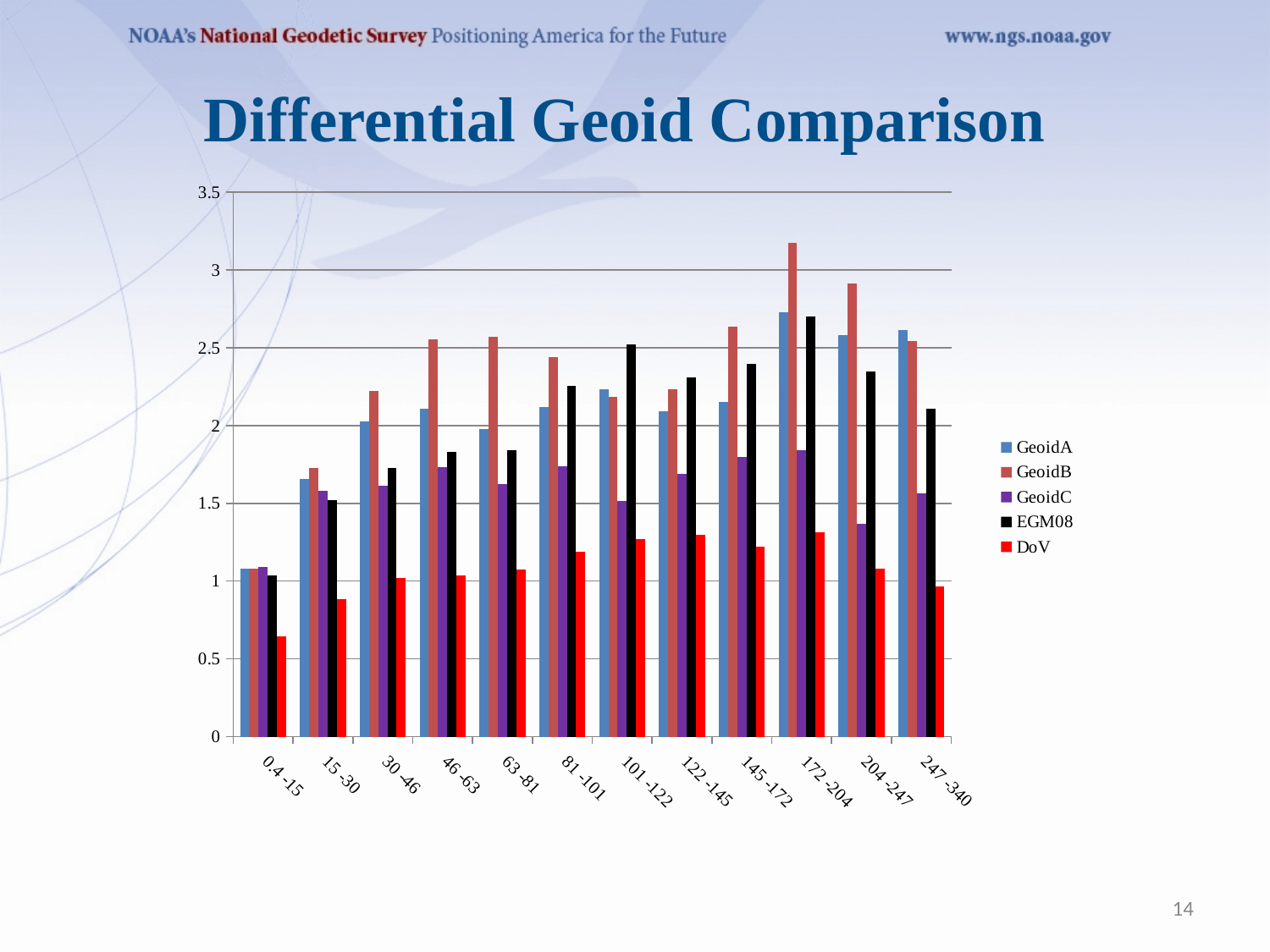
In the 101-122 category, which is larger: EGM08 or GeoidC? EGM08 How many categories are shown along the x axis? 12 Is the GeoidC value for 204-247 greater or less than 1.5? less How many series does the legend list? 5 For which category is the GeoidB value highest? 172-204 Is the GeoidB value for 172-204 greater or less than 3? greater What kind of chart is shown on the slide? bar chart Is the EGM08 value for 172-204 greater or less than 2.5? greater Which series has the lowest value in the 0.4-15 category? DoV What is the title of the chart? Differential Geoid Comparison For which category is the DoV value lowest? 0.4-15